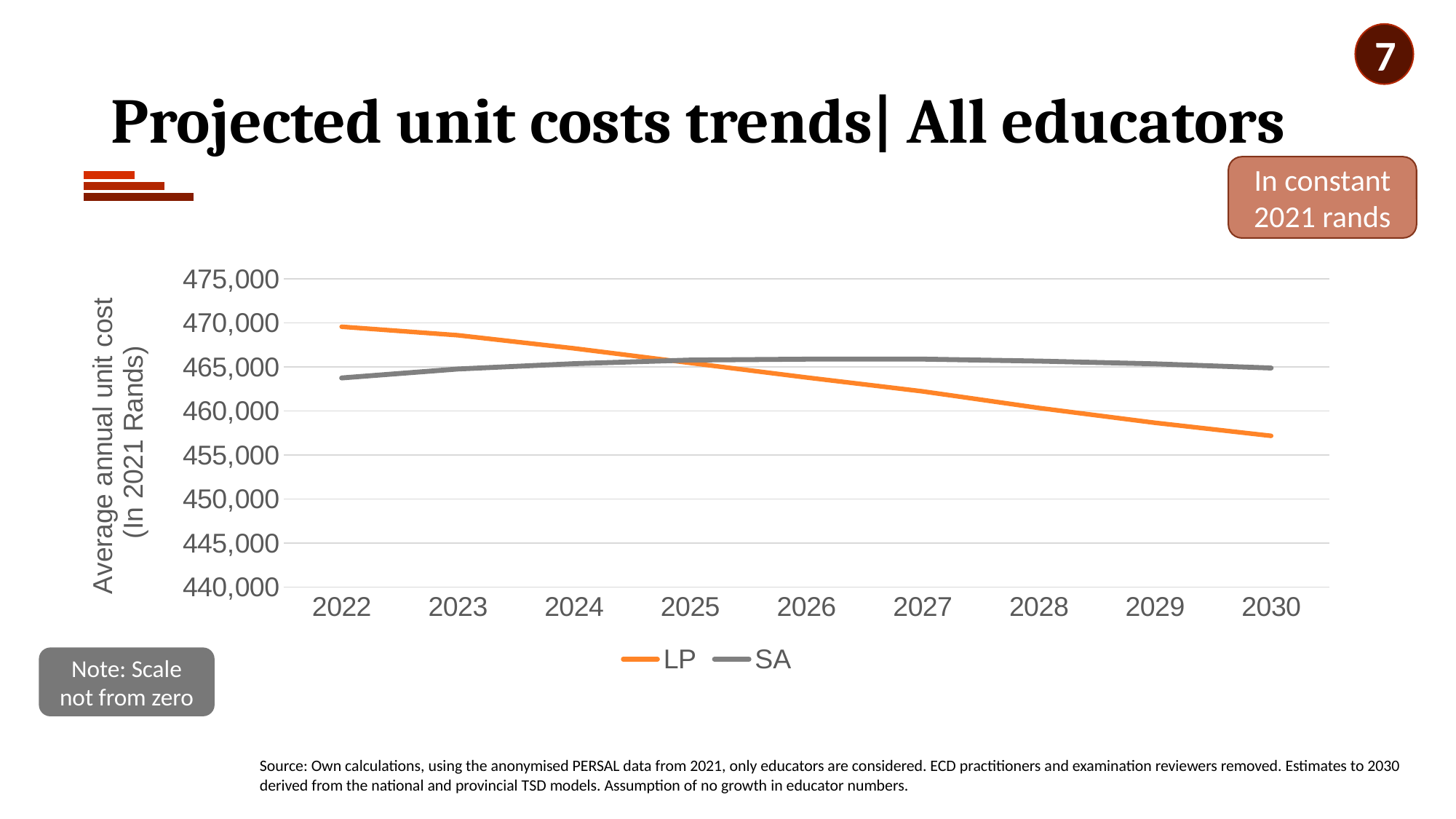
Is the value for LP in 2030 greater or less than 460,000? less Does the LP line rise or fall from 2022 to 2030? fall How many years are plotted along the x axis? 9 In 2022, which series has the higher unit cost, LP or SA? LP Is the value for LP in 2030 greater or less than 455,000? greater What kind of chart is shown on the slide? line chart What is the title of the slide containing the chart? Projected unit costs trends| All educators Which colour is used for the SA series? grey How many series does the legend list? 2 Is the value for SA in 2022 greater or less than 465,000? less In 2030, which series has the higher unit cost, LP or SA? SA